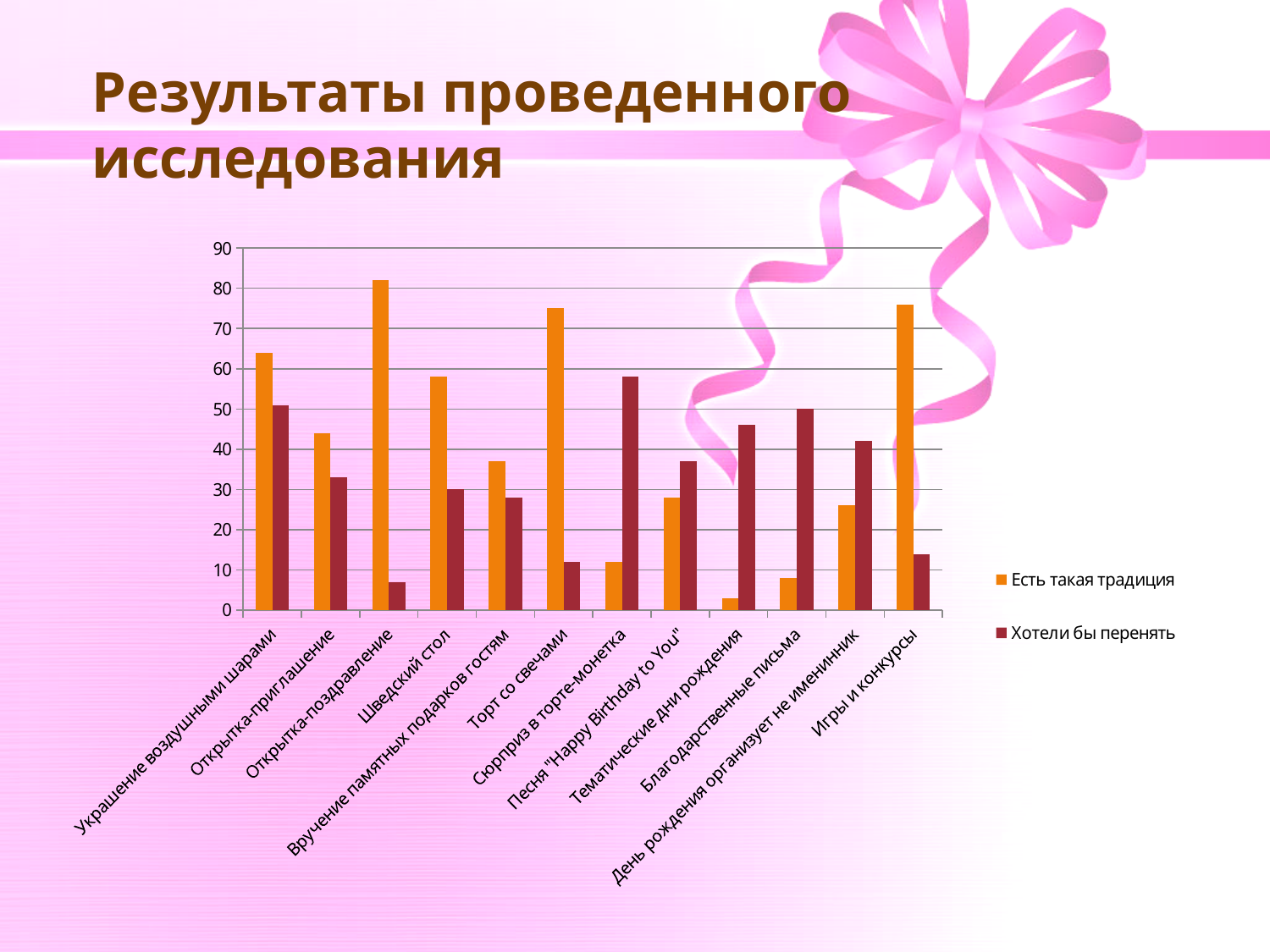
Is the value for "Торт со свечами" in the series "Есть такая традиция" greater or less than 70? greater What kind of chart is shown on the slide? bar chart Which series is shown in orange in the chart's legend? Есть такая традиция How many categories are shown along the x axis of the chart? 12 Is the value for "Тематические дни рождения" in the series "Есть такая традиция" greater or less than 10? less Which category has the lowest value for the series "Есть такая традиция"? Тематические дни рождения Is the value for "Сюрприз в торте-монетка" in the series "Хотели бы перенять" greater or less than 50? greater Which category has the highest value for the series "Хотели бы перенять"? Сюрприз в торте-монетка For "Украшение воздушными шарами", which series has the larger value: "Есть такая традиция" or "Хотели бы перенять"? Есть такая традиция Which category has the lowest value for the series "Хотели бы перенять"? Открытка-поздравление How many series does the chart's legend list? 2 Which category has the highest value for the series "Есть такая традиция"? Открытка-поздравление